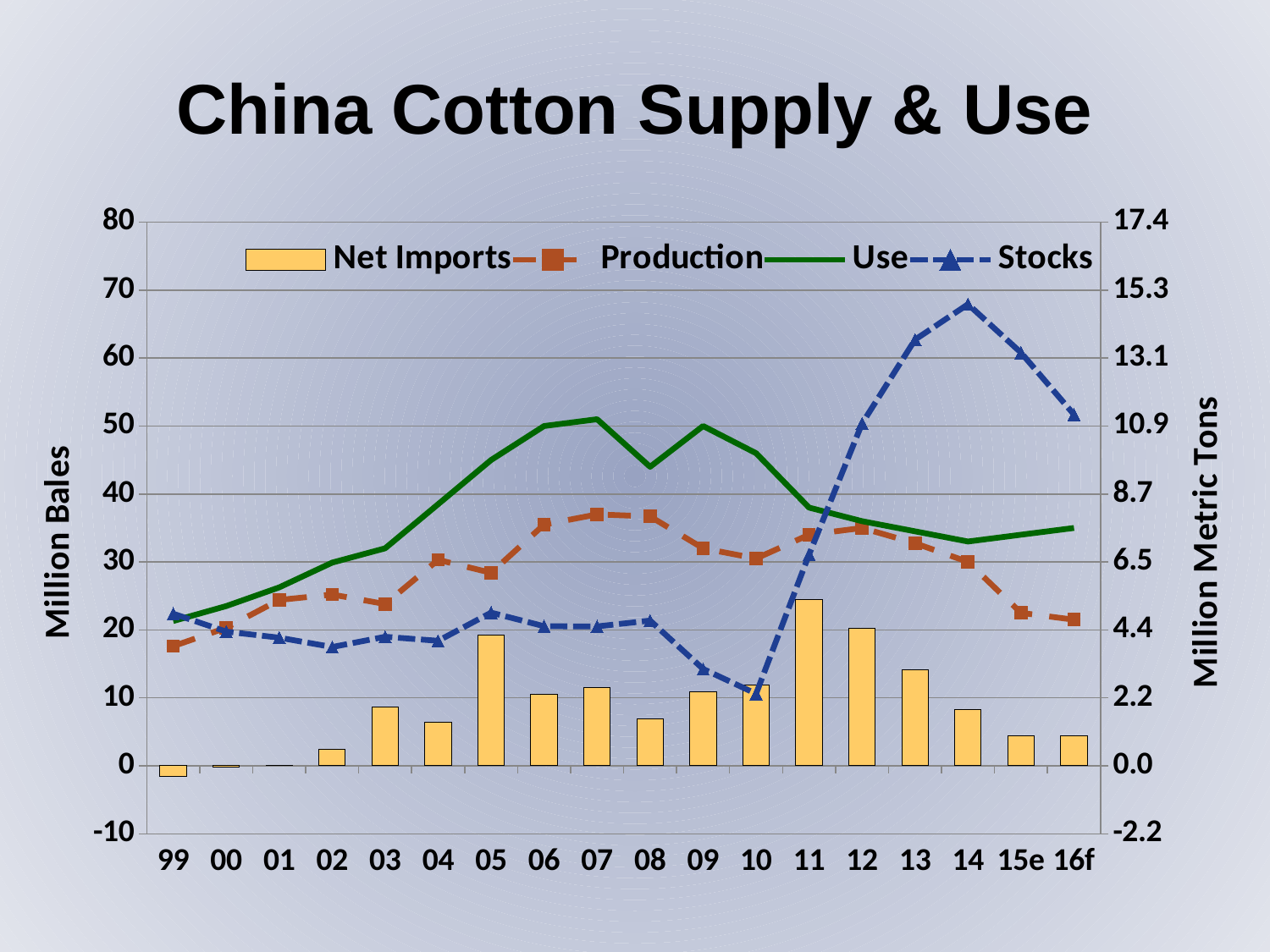
Do Stocks rise or fall from 10 to 14? rise Is the value for Production in 16f greater or less than 30 on the left axis? less In which year are Stocks highest? 14 In which year are Net Imports highest? 11 How many series does the legend list? 4 What is the title of the left vertical axis? Million Bales Which is larger, Net Imports in 11 or Net Imports in 12? 11 Is the value for Stocks in 14 greater or less than 60 on the left axis? greater How many years are shown along the x axis? 18 Is the value for Net Imports in 11 greater or less than 20 million bales? greater What kind of chart is shown on the slide? A combination bar and line chart In which year are Net Imports lowest? 99